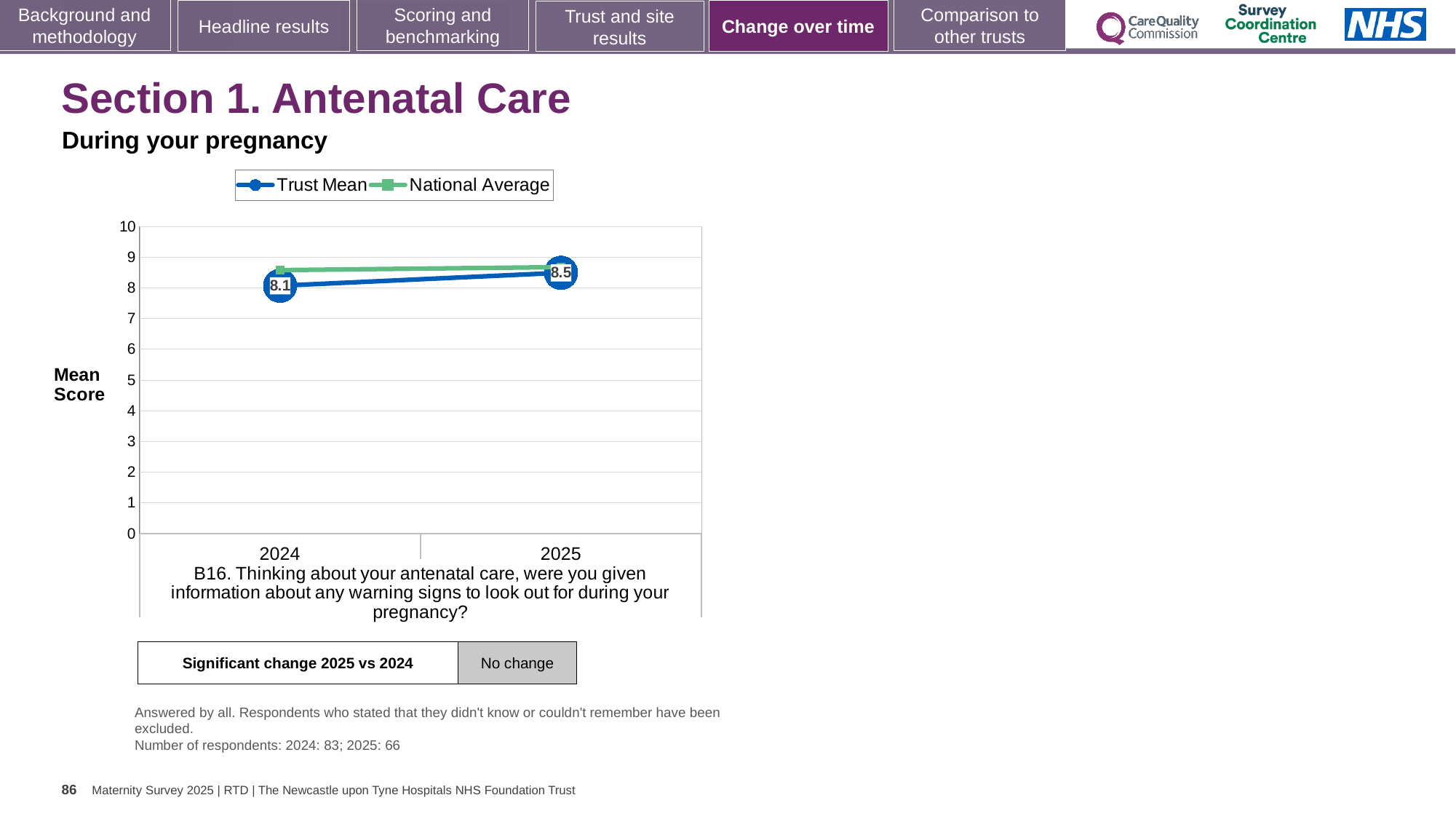
How many series does the legend list? 2 What kind of chart is shown on the slide? line chart Is the National Average value for 2024 greater or less than 8? greater How many years are plotted on the x axis? 2 By how much did the Trust Mean change from 2024 to 2025? 0.4 In which year is the Trust Mean higher, 2024 or 2025? 2025 In 2024, which is higher, the Trust Mean or the National Average? National Average Is the National Average value for 2025 greater or less than 9? less Does the Trust Mean rise or fall from 2024 to 2025? rise What is the label on the y axis of the chart? Mean Score What is the Trust Mean score for 2025? 8.5 What is the Trust Mean score for 2024? 8.1